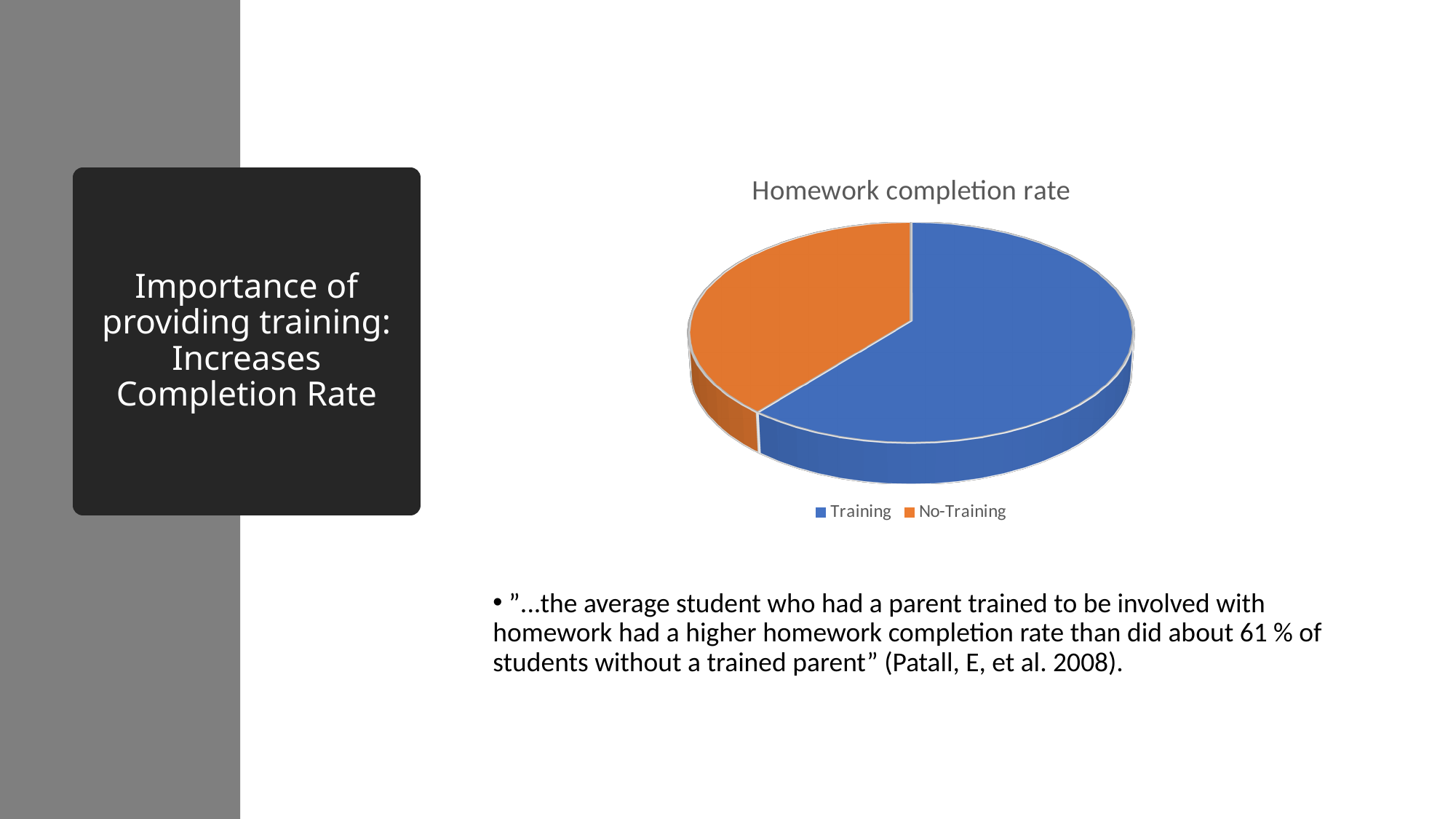
What is the title of the chart? Homework completion rate Which slice of the pie chart is the largest? Training What colour is the Training slice in the pie chart? Blue Which slice of the pie chart is the smallest? No-Training Does the No-Training slice take up more or less than half of the pie? Less Which slice is larger, Training or No-Training? Training How many slices does the pie chart have? 2 How many entries does the chart legend list? 2 Does the Training slice take up more or less than half of the pie? More What kind of chart is shown on the slide? Pie chart